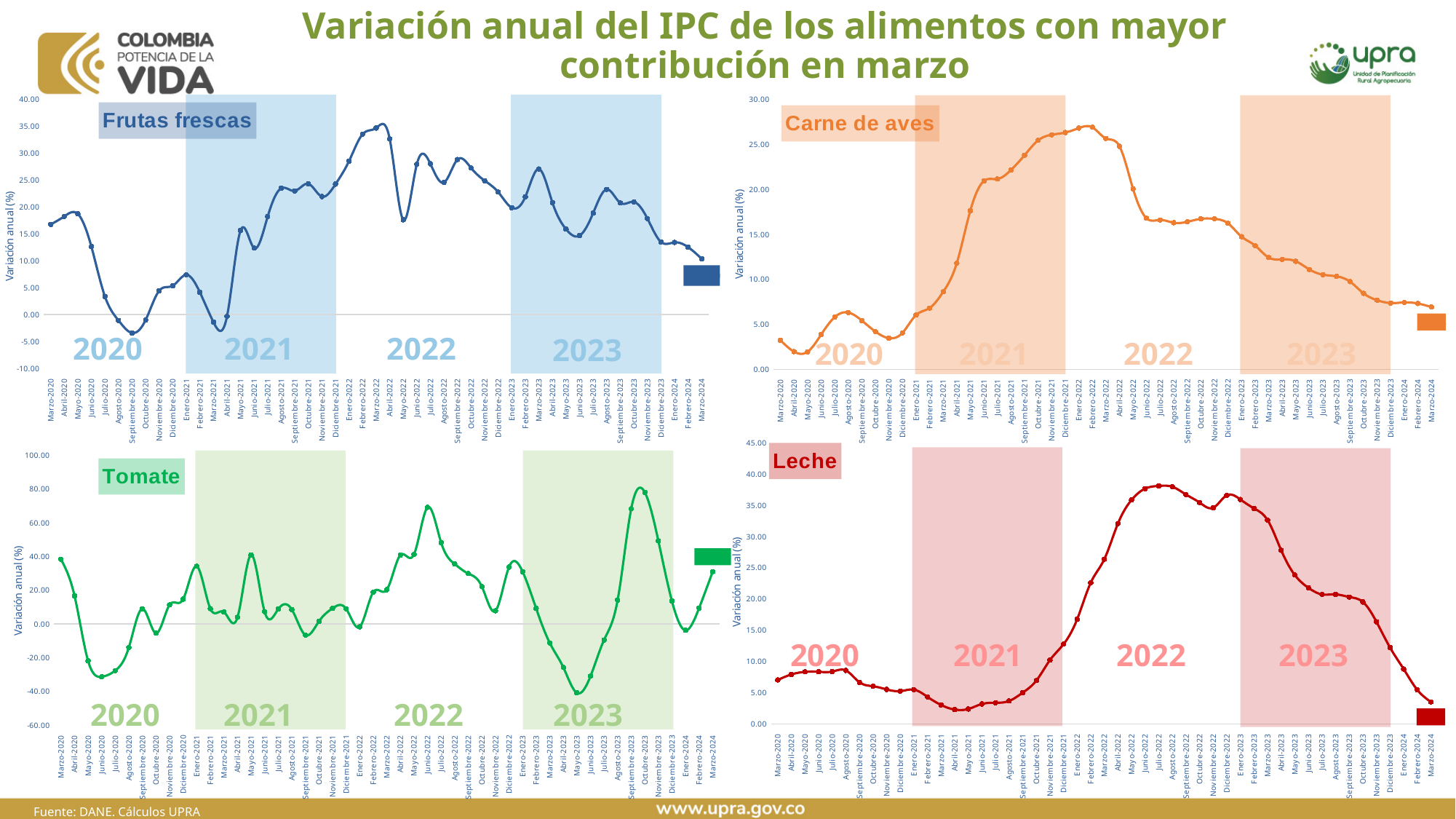
In the Leche chart, do the values rise or fall from Enero-2023 to Marzo-2024? fall In the Carne de aves chart, is the value for Febrero-2022 greater or less than 25? greater In the Frutas frescas chart, which is larger, the value for Abril-2022 or the value for Marzo-2024? Abril-2022 In the Leche chart, is the value for Marzo-2024 greater or less than 5? less In the Carne de aves chart, is the value for Marzo-2024 greater or less than 5? greater In the Tomate chart, which month has the highest value? Octubre-2023 How many charts are shown on the slide? 4 In the Tomate chart, which month has the lowest value? Mayo-2023 What is the label on the vertical axis of the Leche chart? Variación anual (%) What kind of chart is used for the Frutas frescas panel? Line chart